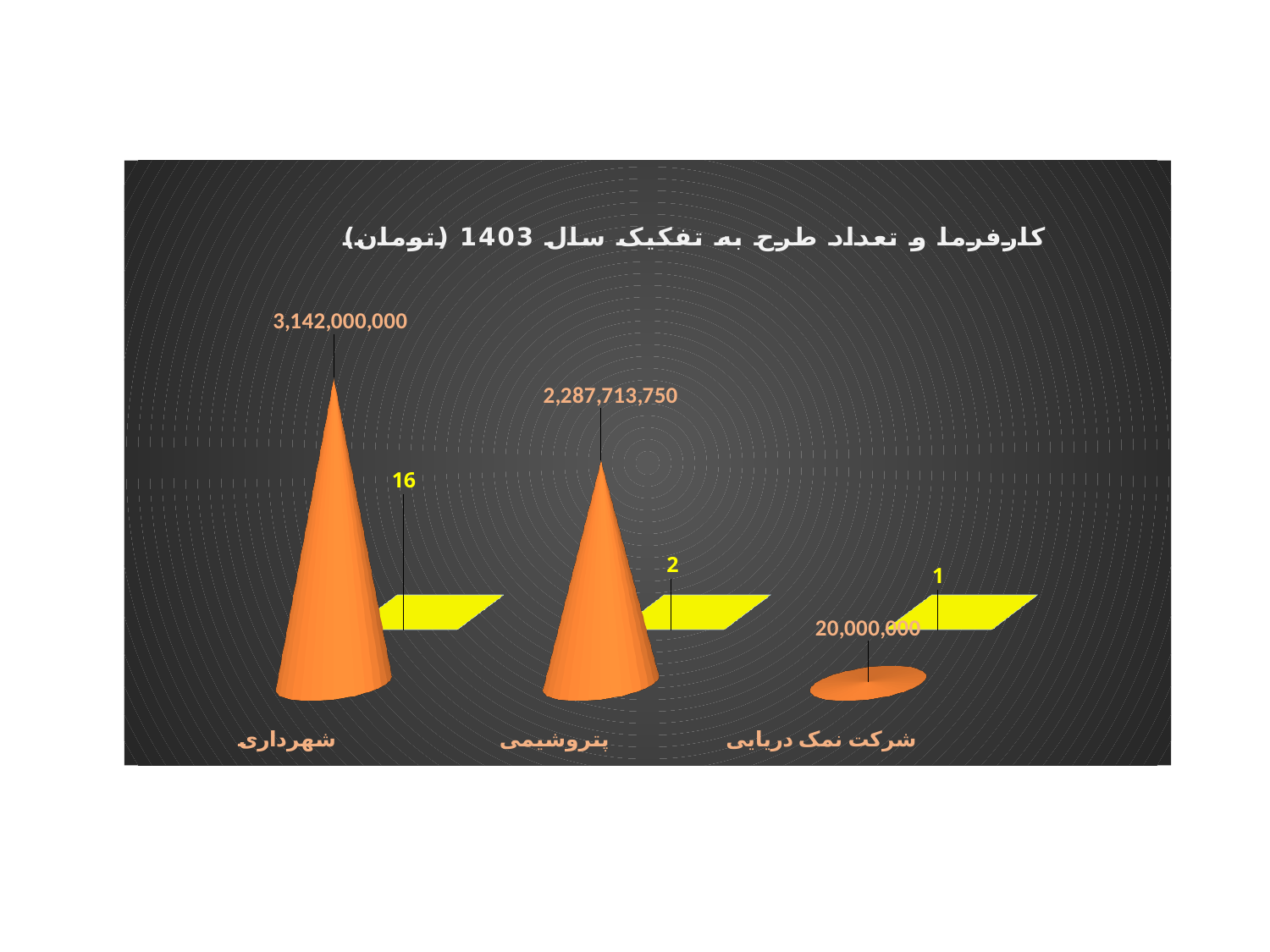
What is the value labelled on the orange cone for شهرداری? 3,142,000,000 How many categories are shown on the x axis? 3 Which category has the highest orange (amount) value? شهرداری What is the value labelled on the orange cone for پتروشیمی? 2,287,713,750 What is the yellow number of projects shown for شهرداری? 16 What is the value labelled on the orange shape for شرکت نمک دریایی? 20,000,000 What is the yellow number of projects shown for پتروشیمی? 2 Which has more projects (yellow value), شهرداری or پتروشیمی? شهرداری What is the difference between the orange values for شهرداری and پتروشیمی? 854,286,250 Which category has the lowest orange (amount) value? شرکت نمک دریایی What is the title of the chart? کارفرما و تعداد طرح به تفکیک سال 1403 (تومان) What is the yellow number of projects shown for شرکت نمک دریایی? 1